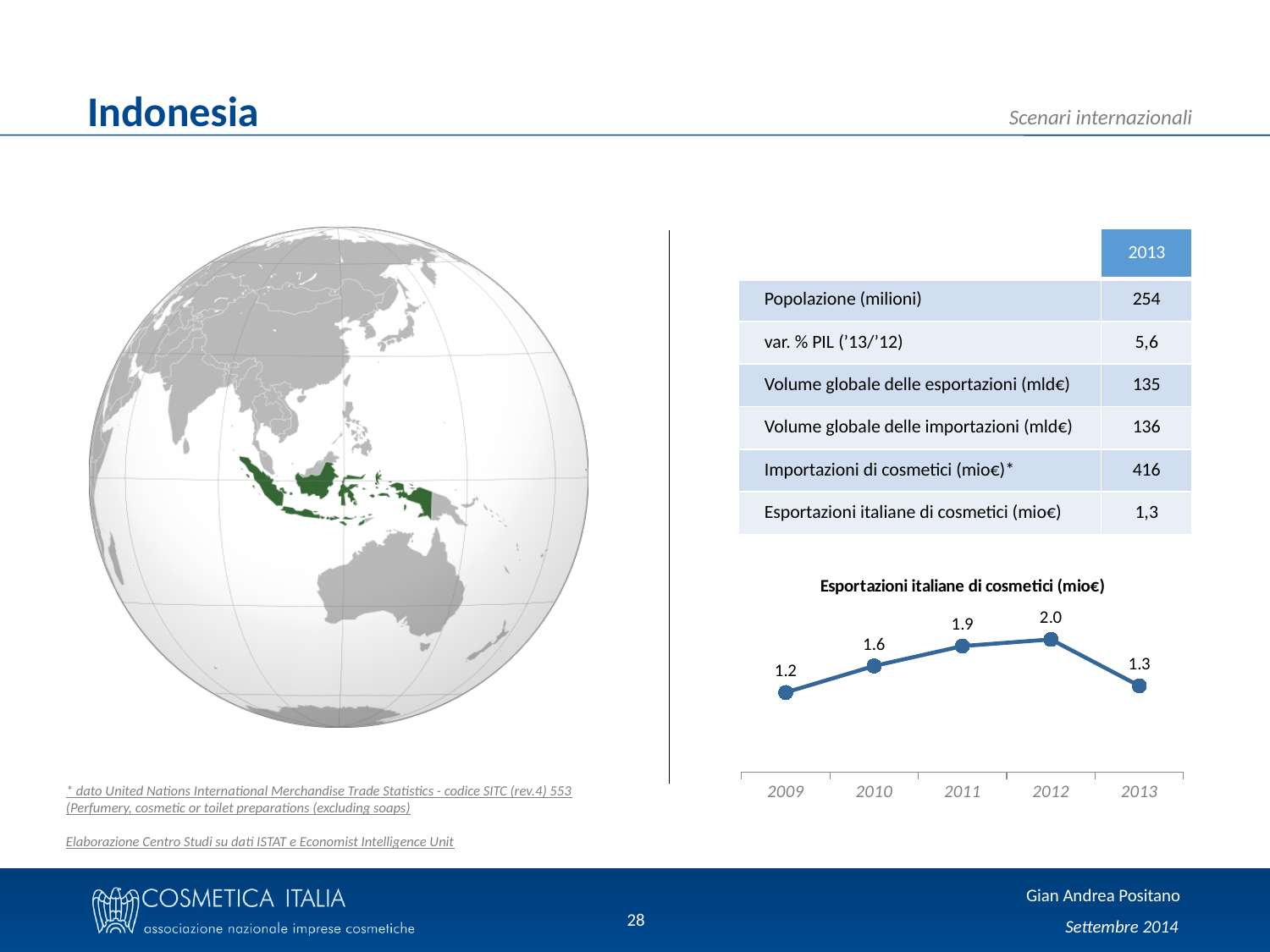
Which year has the highest value in the chart 'Esportazioni italiane di cosmetici (mio€)'? 2012 What is the title of the line chart on the slide? Esportazioni italiane di cosmetici (mio€) What is the difference between the 2010 and 2009 values in the chart 'Esportazioni italiane di cosmetici (mio€)'? 0.4 What is the value for 2011 in the chart 'Esportazioni italiane di cosmetici (mio€)'? 1.9 What is the value for 2013 in the chart 'Esportazioni italiane di cosmetici (mio€)'? 1.3 What is the value for 2009 in the chart 'Esportazioni italiane di cosmetici (mio€)'? 1.2 What is the difference between the 2012 and 2013 values in the chart 'Esportazioni italiane di cosmetici (mio€)'? 0.7 How many years are plotted in the chart 'Esportazioni italiane di cosmetici (mio€)'? 5 Which year has the lowest value in the chart 'Esportazioni italiane di cosmetici (mio€)'? 2009 In the chart 'Esportazioni italiane di cosmetici (mio€)', is the value for 2010 or 2013 larger? 2010 What kind of chart is 'Esportazioni italiane di cosmetici (mio€)'? line chart In the chart 'Esportazioni italiane di cosmetici (mio€)', do the values rise or fall from 2009 to 2012? rise